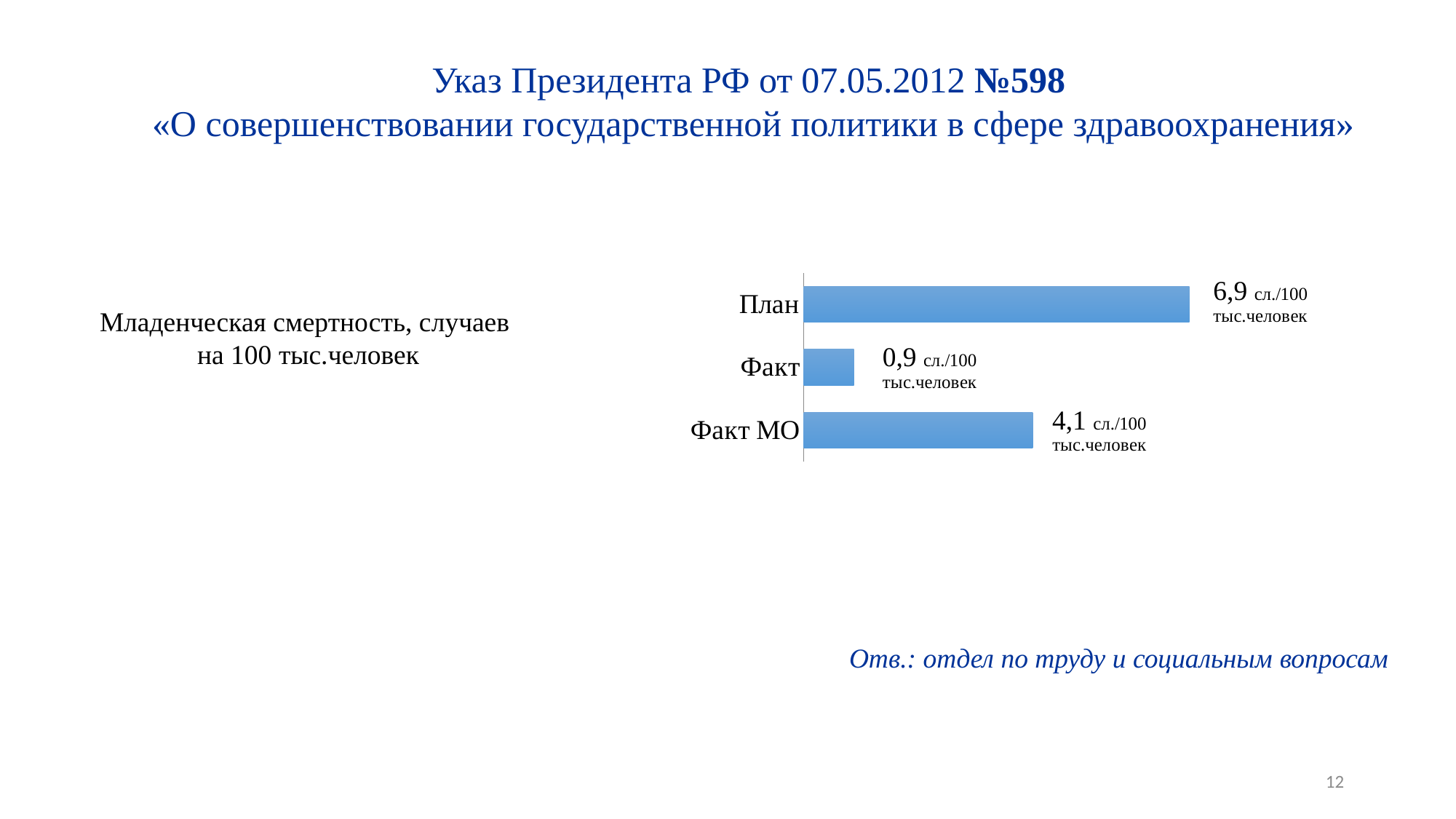
What kind of chart is shown on the slide? Bar chart Which category has the lowest value? Факт Which is larger, the value for Факт МО or the value for Факт? Факт МО What is the difference between the values for План and Факт? 6,0 сл./100 тыс.человек What is the difference between the values for Факт МО and Факт? 3,2 сл./100 тыс.человек How many categories are shown in the chart? 3 What colour are the bars in the chart? Blue What is the value for Факт МО? 4,1 сл./100 тыс.человек Which category has the highest value? План What is the value for Факт? 0,9 сл./100 тыс.человек What indicator does the chart describe, according to the text to the left of it? Младенческая смертность, случаев на 100 тыс.человек What is the value for План? 6,9 сл./100 тыс.человек